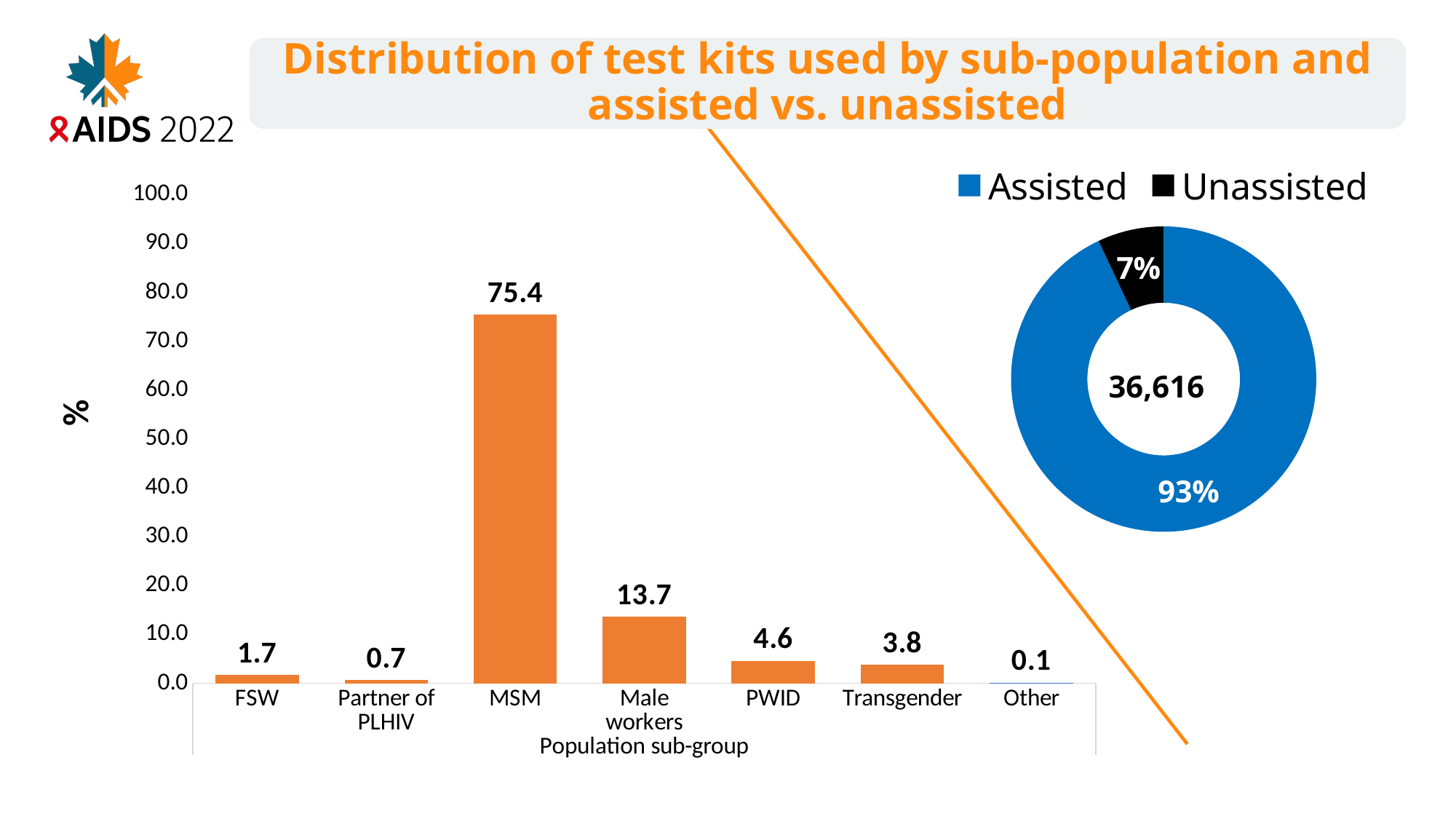
In the bar chart on the left, which population sub-group has the lowest value? Other In the bar chart on the left, what is the value for Male workers? 13.7 In the bar chart on the left, what is the difference between the values for MSM and Male workers? 61.7 In the doughnut chart on the right, what share of test kits were Assisted? 93% In the doughnut chart on the right, what share of test kits were Unassisted? 7% In the bar chart on the left, which population sub-group has the highest value? MSM In the bar chart on the left, how many population sub-groups are shown? 7 What number is shown in the centre of the doughnut chart on the right? 36,616 What kind of chart is the chart on the left of the slide? Bar chart In the bar chart on the left, which is larger, the value for PWID or the value for Transgender? PWID In the bar chart on the left, what is the value for MSM? 75.4 In the bar chart on the left, what is the value for Partner of PLHIV? 0.7